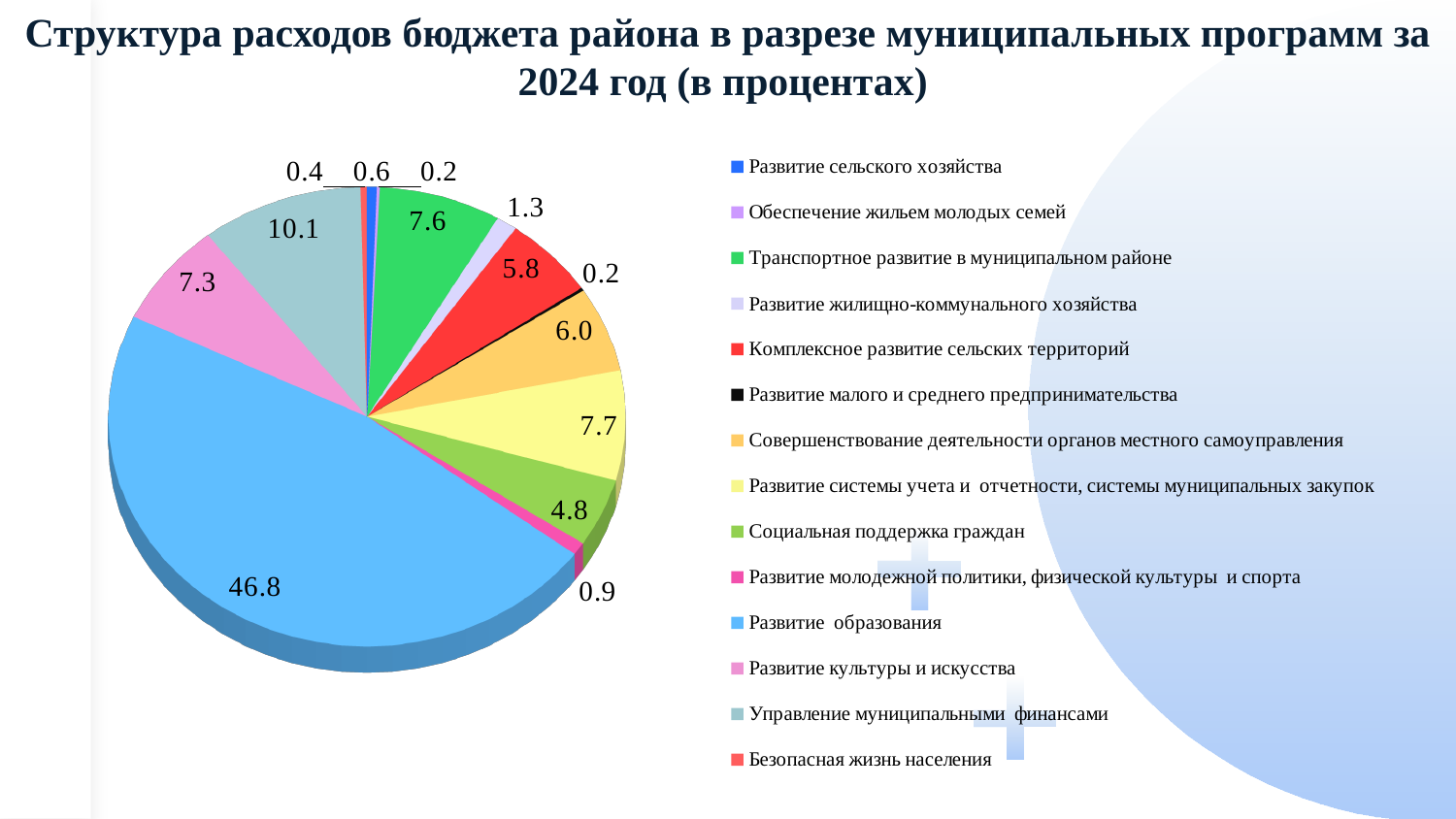
What is the share of expenditures for "Развитие молодежной политики, физической культуры и спорта"? 0.9 How many categories does the legend of the pie chart list? 14 What is the difference between the shares of "Управление муниципальными финансами" and "Развитие культуры и искусства"? 2.8 What year does the chart title say the budget expenditure structure refers to? 2024 What is the share of expenditures for "Социальная поддержка граждан"? 4.8 What is the share of expenditures for "Развитие образования"? 46.8 What is the share of expenditures for "Комплексное развитие сельских территорий"? 5.8 What is the share of expenditures for "Управление муниципальными финансами"? 10.1 Which program has the largest share of district budget expenditures in 2024? Развитие образования What kind of chart is shown on the slide? Pie chart Which has a larger share: "Совершенствование деятельности органов местного самоуправления" or "Социальная поддержка граждан"? Совершенствование деятельности органов местного самоуправления What is the share of expenditures for "Развитие культуры и искусства"? 7.3